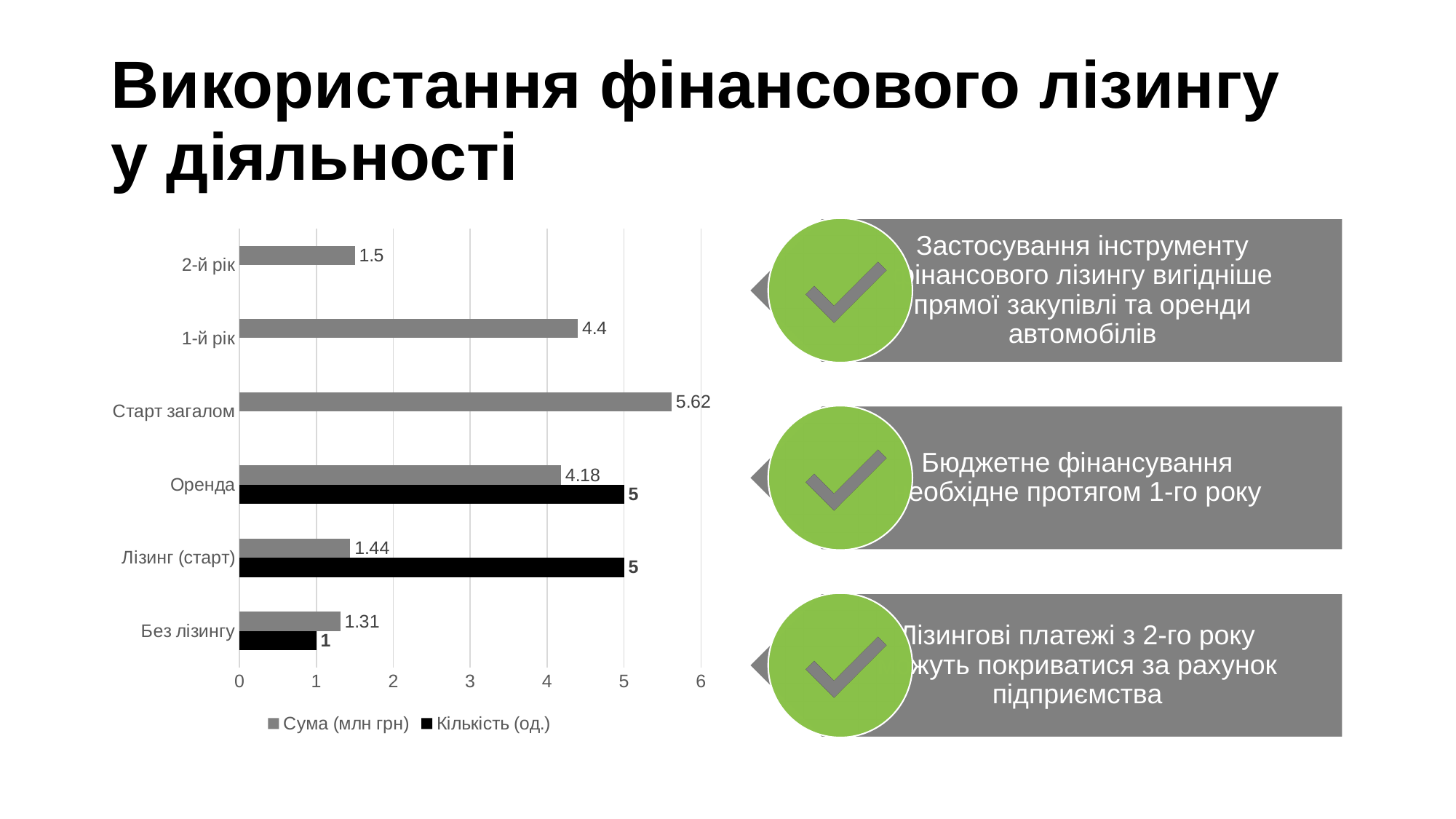
Is the Сума (млн грн) value for Старт загалом greater or less than 5? greater Which category has the lowest value for Сума (млн грн)? Без лізингу What is the value of Сума (млн грн) for 1-й рік? 4.4 What is the value of Кількість (од.) for Без лізингу? 1 How many series does the legend list? 2 What is the value of Сума (млн грн) for Старт загалом? 5.62 Which category has the highest value for Сума (млн грн)? Старт загалом Which has a larger Сума (млн грн) value, Оренда or Лізинг (старт)? Оренда What is the difference between the Сума (млн грн) values for 1-й рік and 2-й рік? 2.9 How many categories are shown on the chart? 6 What kind of chart is shown on the slide? Bar chart What is the value of Кількість (од.) for Оренда? 5